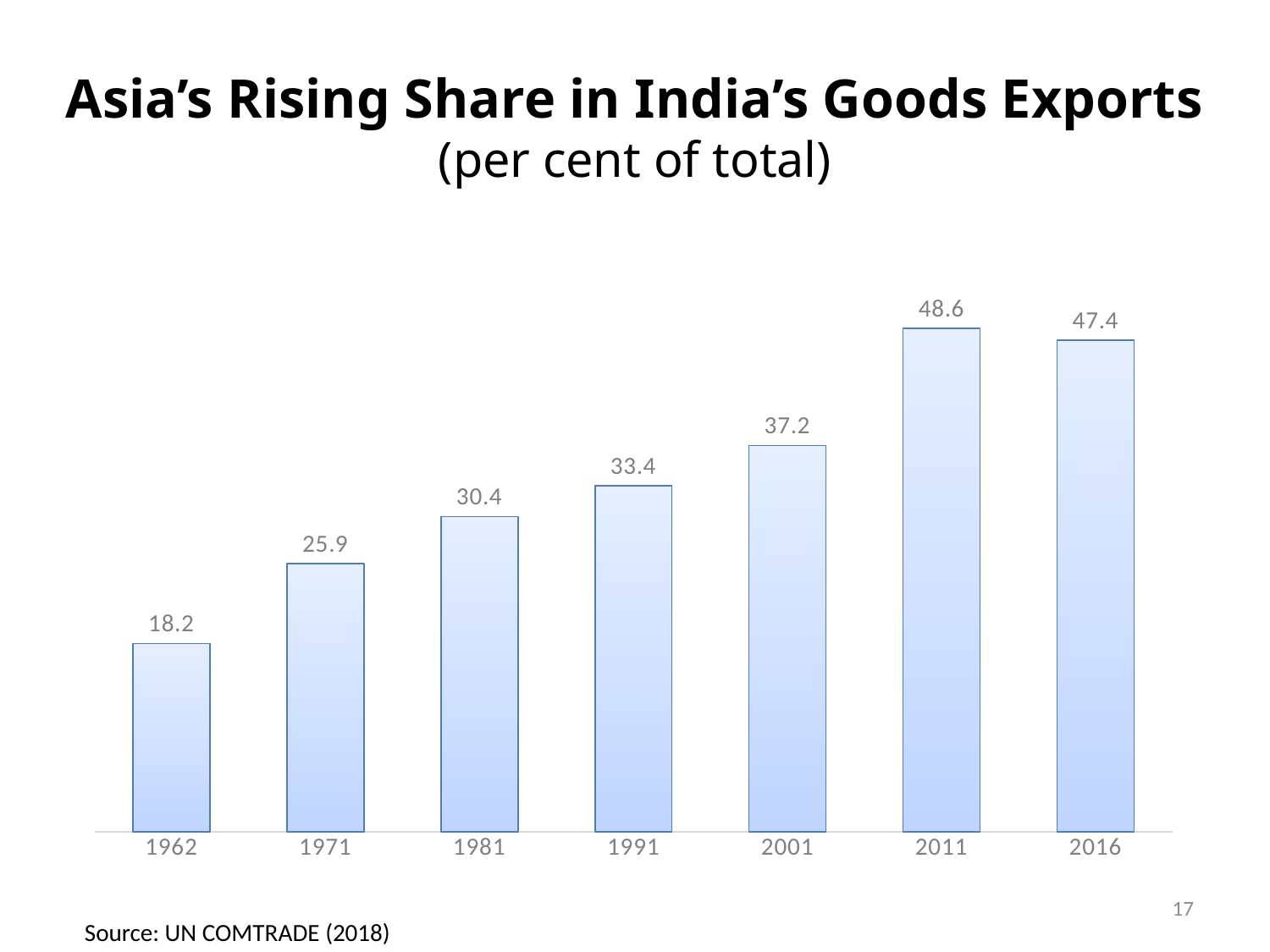
How many years are shown on the x axis? 7 What is the title of the chart? Asia's Rising Share in India's Goods Exports (per cent of total) What value is shown for 2016? 47.4 What kind of chart is shown on the slide? Bar chart Which year has the highest value? 2011 What is Asia's share in India's goods exports in 1962? 18.2 Do the values generally rise or fall from 1962 to 2011? Rise Which is larger, the value for 1991 or the value for 2001? 2001 What value is shown for 2001? 37.2 Which year has the lowest value? 1962 What is the difference between the values for 2011 and 2016? 1.2 What is the difference between the values for 1981 and 1971? 4.5